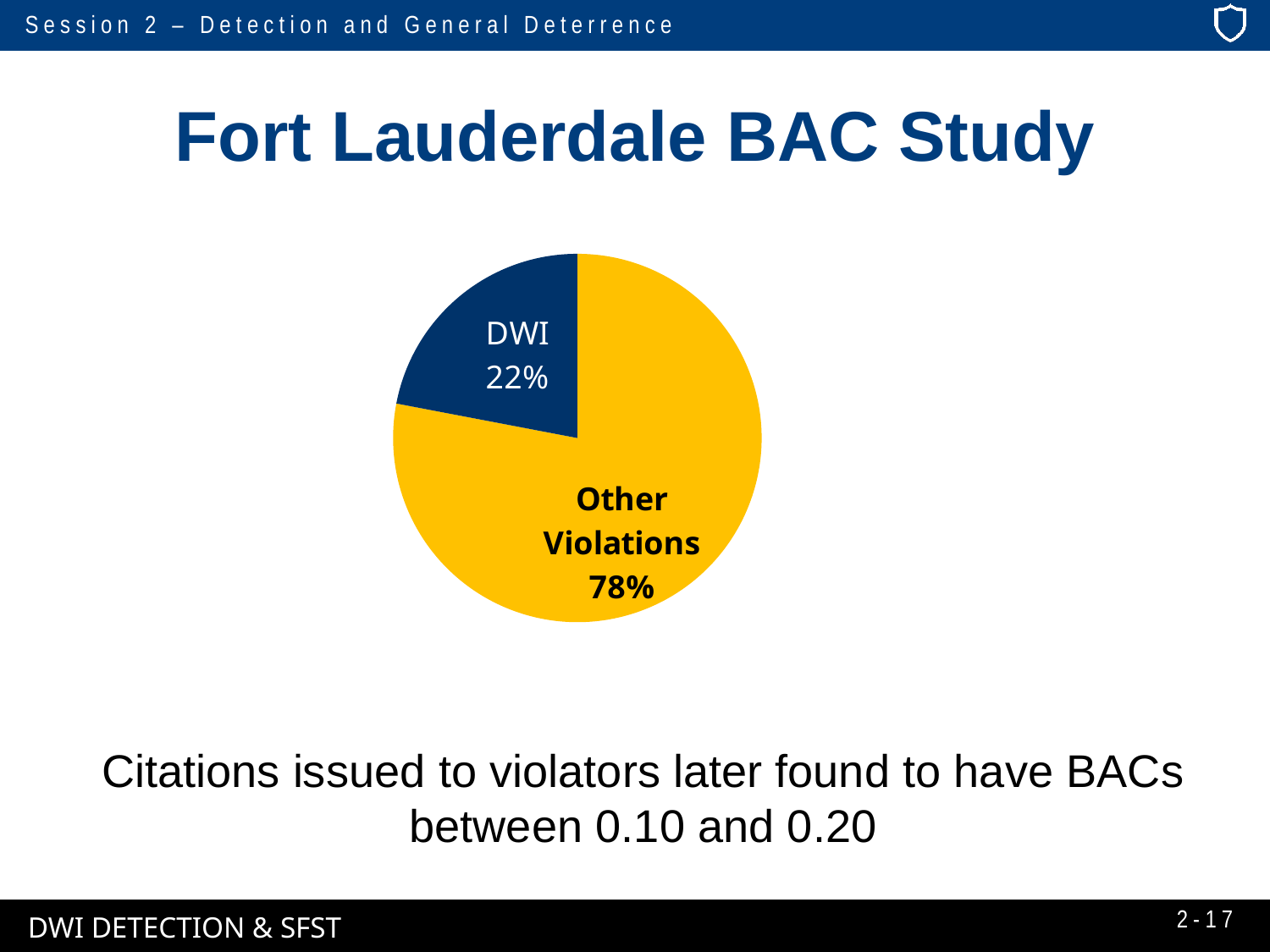
What kind of chart is shown on the slide? Pie chart Which slice of the pie is the smallest? DWI What is the difference in percentage points between the Other Violations slice and the DWI slice? 56 Which slice of the pie is the largest? Other Violations Which is larger, the DWI slice or the Other Violations slice? Other Violations What colour is the DWI slice of the pie chart? Dark blue Is the DWI share of the pie greater or less than 50%? less What share of the pie is labelled Other Violations? 78% What is the total of the two slice percentages shown on the pie chart? 100% How many slices does the pie chart have? 2 What share of the pie is labelled DWI? 22% What is the title of the slide containing the pie chart? Fort Lauderdale BAC Study